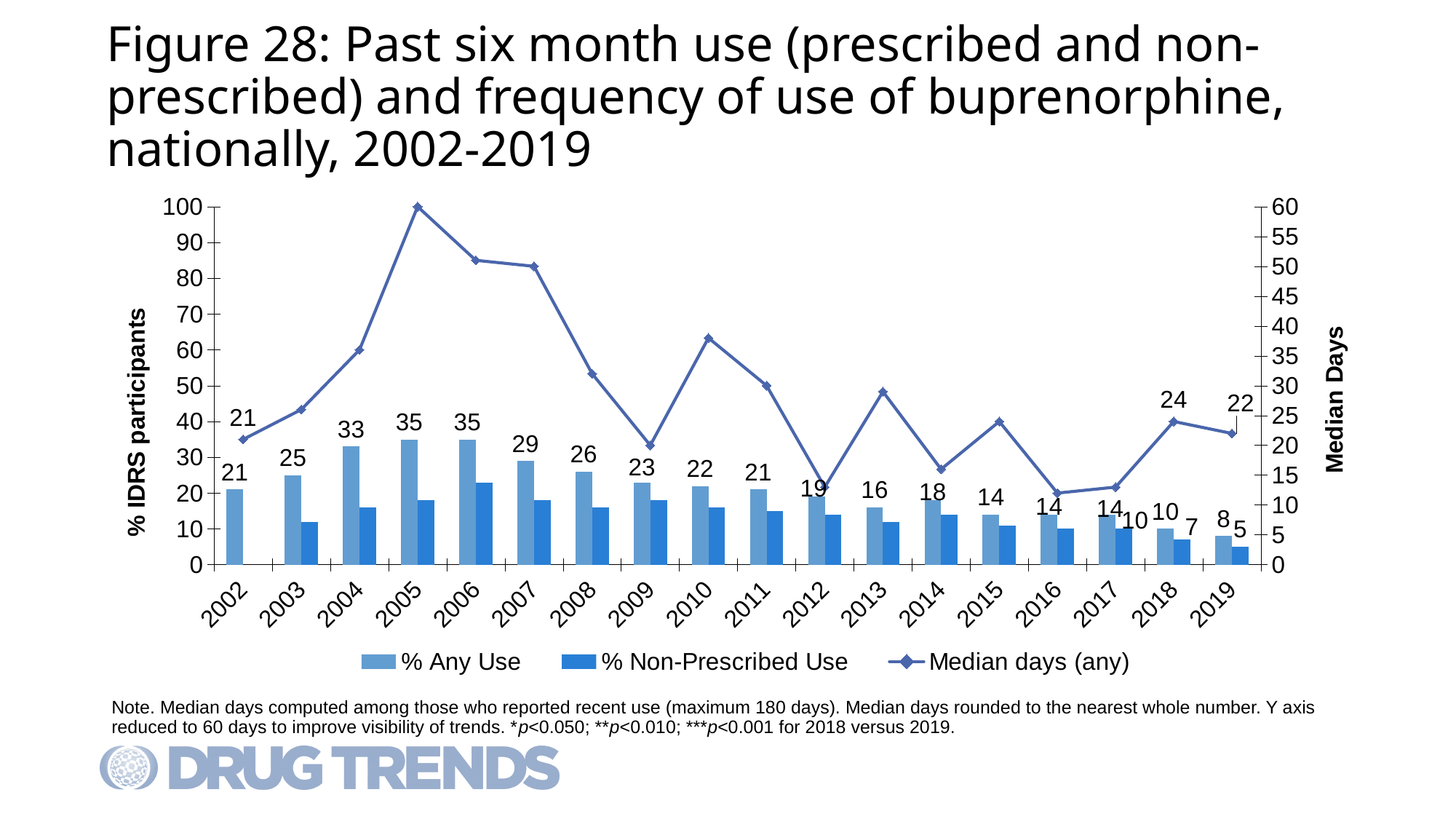
Is the Median days (any) value for 2005 greater or less than 50? greater Which year has the larger % Any Use value, 2007 or 2008? 2007 What is the % Non-Prescribed Use value for 2019? 5 What is the difference between the % Any Use values for 2004 and 2003? 8 What is the difference between % Any Use and % Non-Prescribed Use in 2019? 3 Is the % Non-Prescribed Use value for 2006 greater or less than 20? greater How many years are shown on the x axis? 18 Does the % Any Use series rise or fall from 2006 to 2019? fall What is the Median days (any) value for 2018? 24 What is the % Any Use value for 2004? 33 How many series does the legend list? 3 Which year has the lowest % Any Use value? 2019